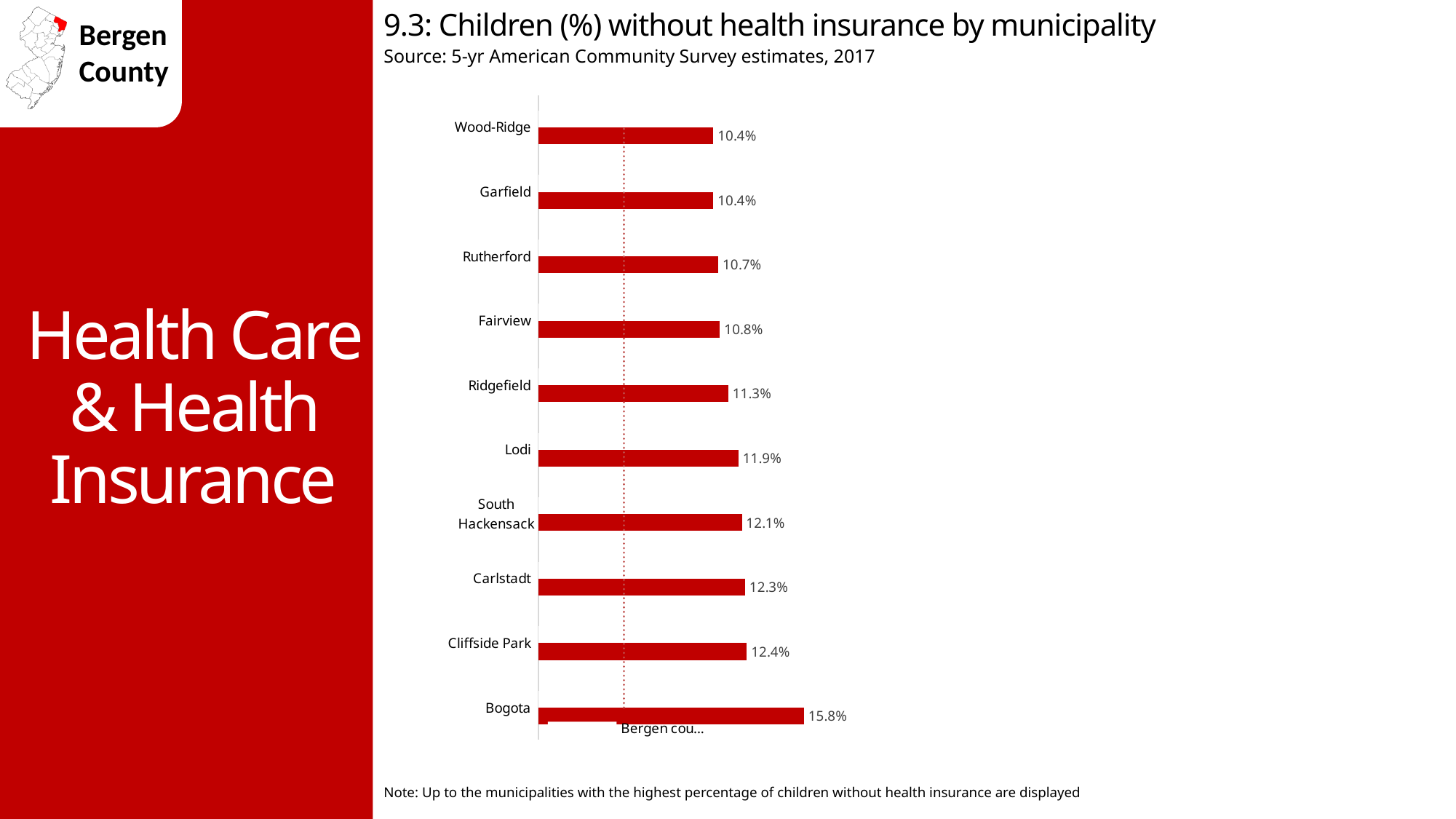
What is the value shown for South Hackensack? 12.1% Which has a higher value, Fairview or Ridgefield? Ridgefield What percentage of children in Bogota are without health insurance? 15.8% How many municipalities are shown on the chart? 10 What type of chart is shown on the slide? Bar chart What is the value shown for Lodi? 11.9% Which municipality has the highest percentage of children without health insurance? Bogota What is the difference in percentage points between Bogota and Cliffside Park? 3.4 What is the title of the chart? 9.3: Children (%) without health insurance by municipality What is the difference in percentage points between Carlstadt and Wood-Ridge? 1.9 What is the lowest percentage value shown on the chart? 10.4% What is the value shown for Rutherford? 10.7%